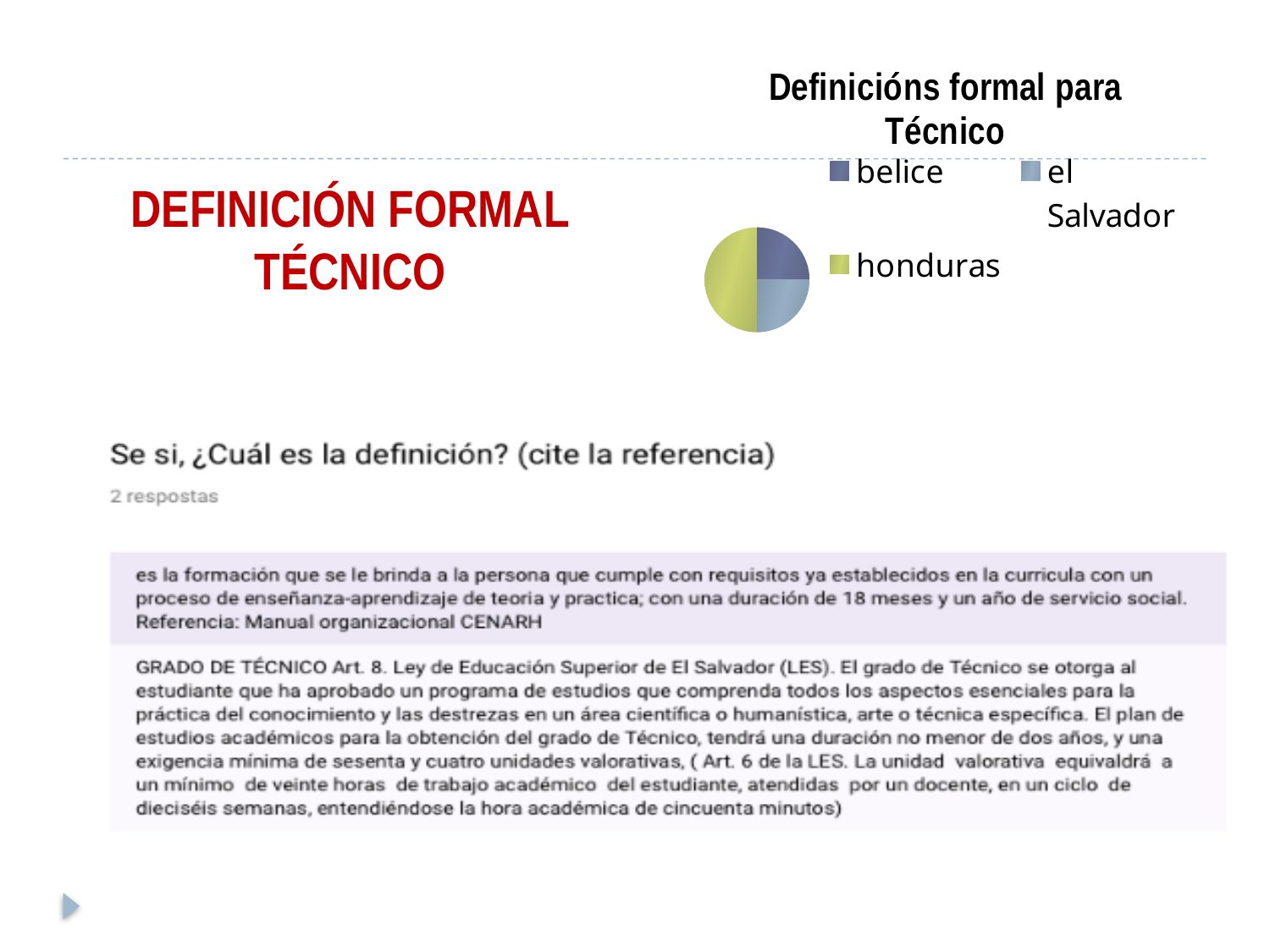
Which slice is larger in the pie chart, honduras or belice? honduras What kind of chart is shown on the slide? pie chart Which category has the largest slice in the pie chart? honduras Which legend entry of the pie chart is shown in yellow-green? honduras How many slices does the pie chart have? 3 Which slice is larger in the pie chart, el Salvador or honduras? honduras How many entries does the legend of the pie chart list? 3 What is the title of the pie chart? Definicións formal para Técnico